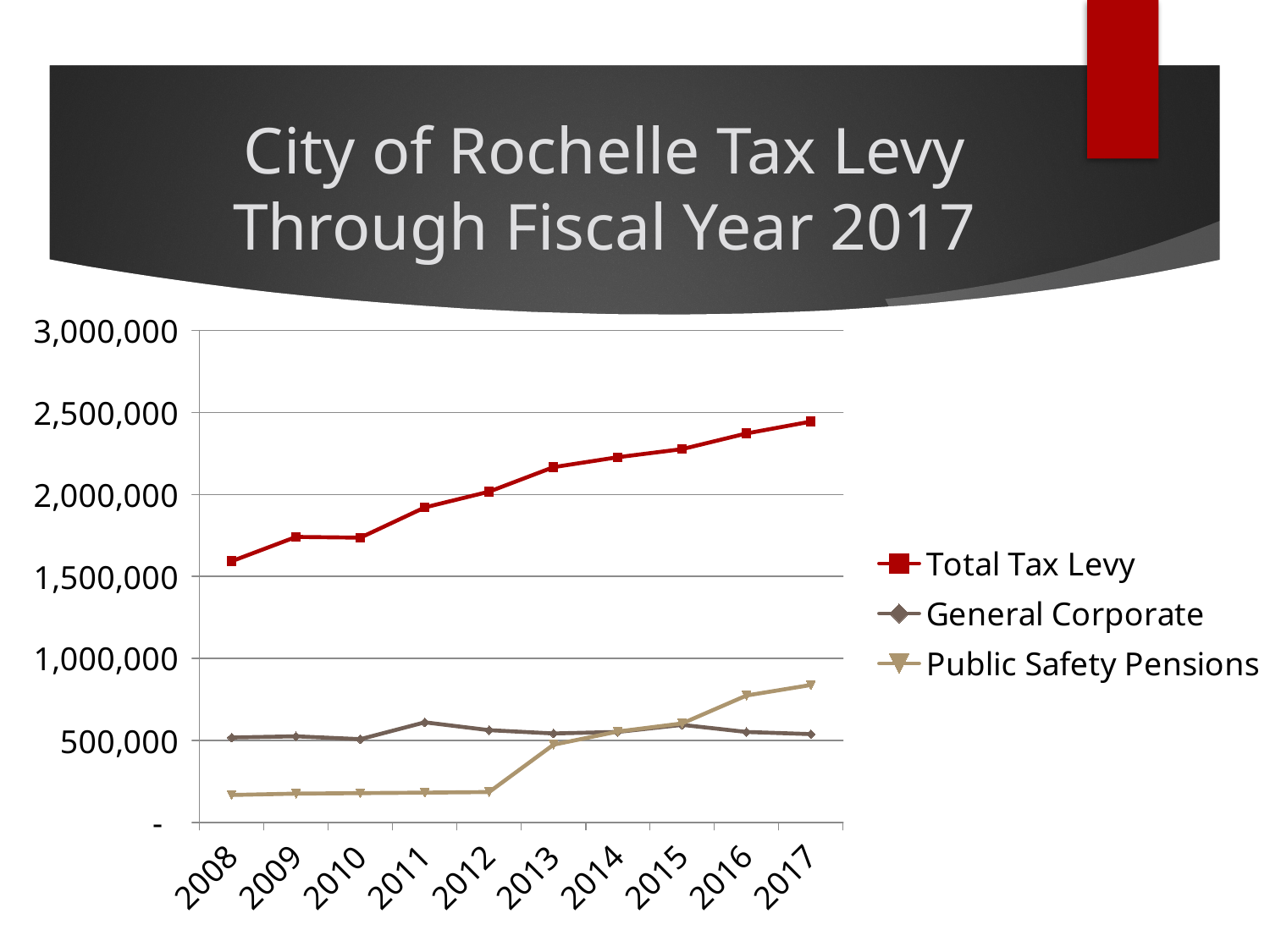
In which year is the Total Tax Levy highest? 2017 How many years are plotted along the x axis? 10 In which year is the Total Tax Levy lowest? 2008 What is the title of the slide containing the chart? City of Rochelle Tax Levy Through Fiscal Year 2017 Is the Public Safety Pensions value for 2017 greater or less than 1,000,000? less Is the Public Safety Pensions value for 2008 greater or less than 500,000? less Is the Total Tax Levy value for 2017 greater or less than 2,500,000? less Does the Total Tax Levy rise or fall from 2008 to 2017? rise In 2017, which is larger: General Corporate or Public Safety Pensions? Public Safety Pensions How many series does the legend list? 3 What kind of chart is shown on the slide? line chart